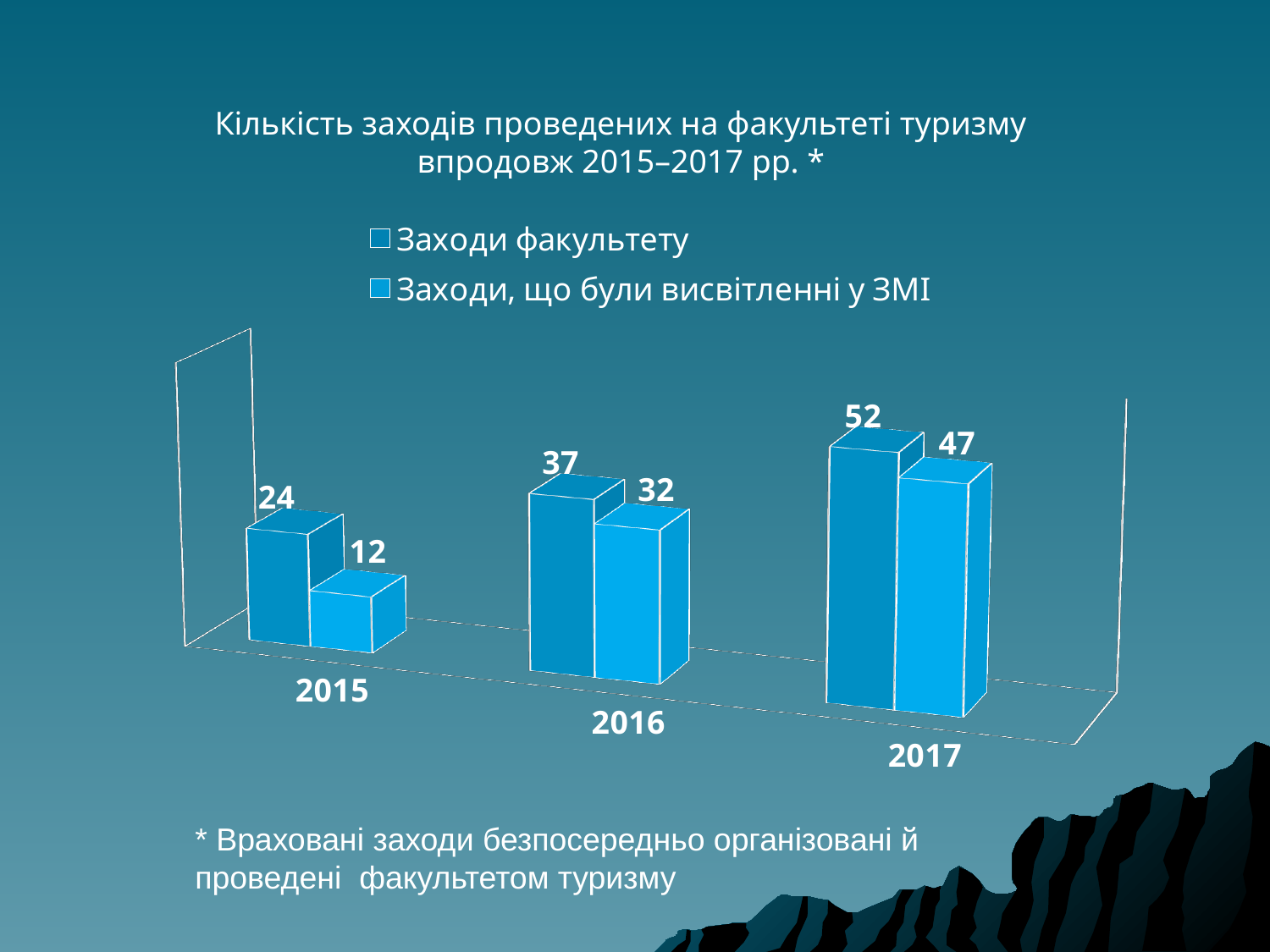
Which is larger in 2016: "Заходи факультету" or "Заходи, що були висвітленні у ЗМІ"? Заходи факультету What is the value for "Заходи, що були висвітленні у ЗМІ" in 2016? 32 Which year has the lowest value for "Заходи факультету"? 2015 How many years are shown on the x axis? 3 Do the values for "Заходи, що були висвітленні у ЗМІ" rise or fall from 2015 to 2017? Rise How many series does the legend list? 2 What is the value for "Заходи факультету" in 2017? 52 What is the difference between "Заходи факультету" and "Заходи, що були висвітленні у ЗМІ" in 2015? 12 What is the difference between the 2017 and 2016 values for "Заходи факультету"? 15 What is the value for "Заходи факультету" in 2015? 24 Which year has the highest value for "Заходи, що були висвітленні у ЗМІ"? 2017 What kind of chart is shown on the slide? Bar chart